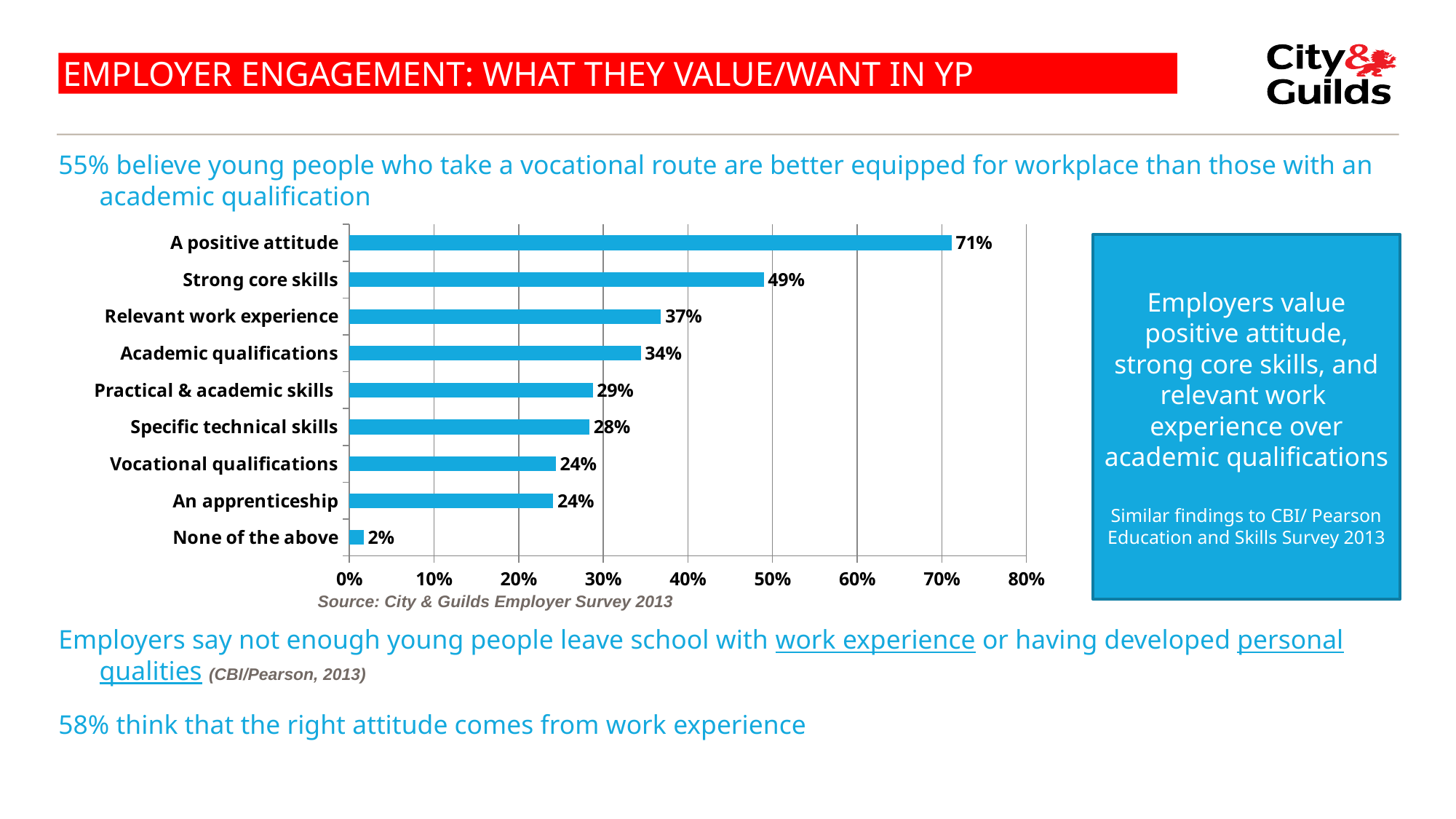
How many categories are shown in the chart? 9 Which category has the lowest value? None of the above What is the value for Relevant work experience? 37% What kind of chart is shown on the slide? bar chart What is the difference between the values for Strong core skills and Academic qualifications? 15% What is the difference between the values for A positive attitude and Vocational qualifications? 47% Which category has the highest value? A positive attitude What is the value for A positive attitude? 71% What is the value for Specific technical skills? 28% Is the value for Strong core skills greater or less than 40%? greater What source is cited below the chart? City & Guilds Employer Survey 2013 Which is larger, the value for Academic qualifications or the value for Practical & academic skills? Academic qualifications